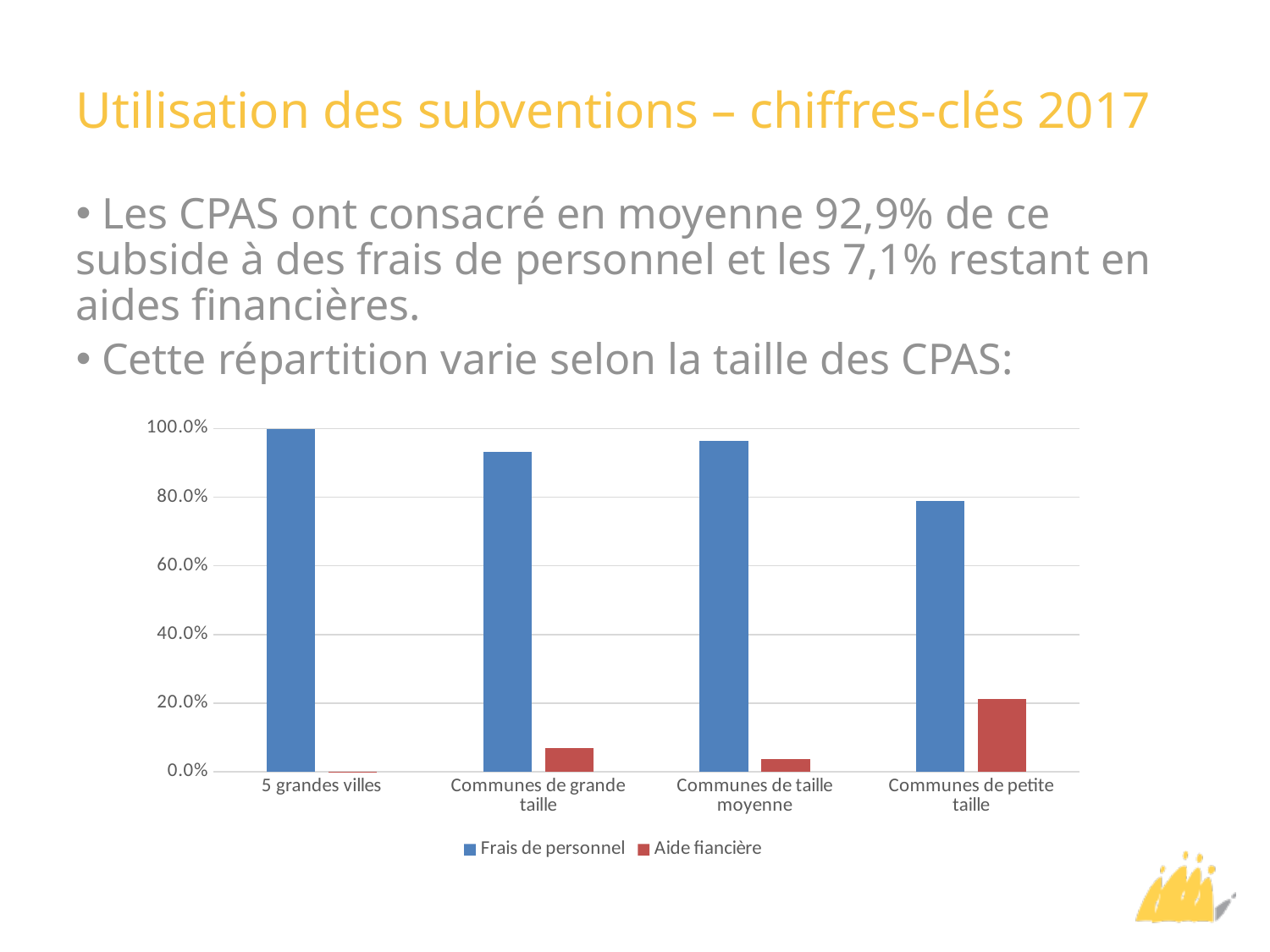
What kind of chart is shown on the slide? bar chart How many series does the chart's legend list? 2 Is the value for Aide fiancière in Communes de grande taille greater or less than 20.0%? less Is the value for Aide fiancière in Communes de petite taille greater or less than 10.0%? greater Which category has the lowest value for Aide fiancière? 5 grandes villes Which category has the highest value for Frais de personnel? 5 grandes villes Is the value for Frais de personnel in Communes de petite taille greater or less than 60.0%? greater Which category has the highest value for Aide fiancière? Communes de petite taille How many categories are shown on the x axis of the chart? 4 What colour are the bars for the Aide fiancière series? red Which category has the lowest value for Frais de personnel? Communes de petite taille Which is larger: the Aide fiancière value for Communes de grande taille or for Communes de taille moyenne? Communes de grande taille